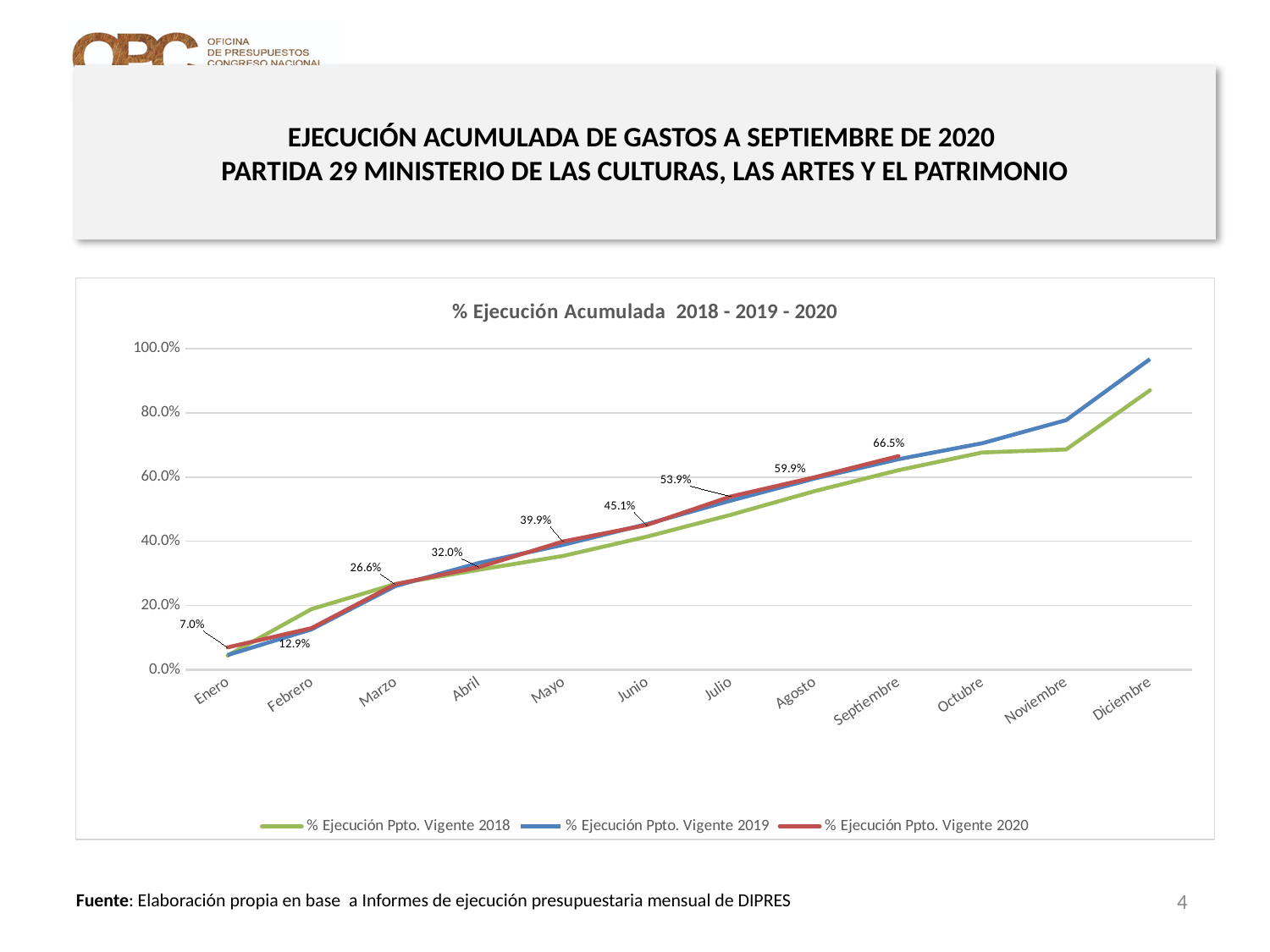
What is the value for % Ejecución Ppto. Vigente 2020 in Julio? 53.9% What is the value for % Ejecución Ppto. Vigente 2020 in Enero? 7.0% What is the difference between the 2020 values for Septiembre and Agosto? 6.6 percentage points How many months are shown on the x axis? 12 In which month does the % Ejecución Ppto. Vigente 2020 series reach its highest labelled value? Septiembre What is the difference between the 2020 values for Marzo and Febrero? 13.7 percentage points What is the value for % Ejecución Ppto. Vigente 2020 in Septiembre? 66.5% What is the value for % Ejecución Ppto. Vigente 2020 in Mayo? 39.9% How many series does the legend list? 3 Which series has the higher value in Diciembre, 2018 or 2019? % Ejecución Ppto. Vigente 2019 What kind of chart is shown? Line chart Is the value for % Ejecución Ppto. Vigente 2019 in Diciembre greater or less than 80.0%? greater